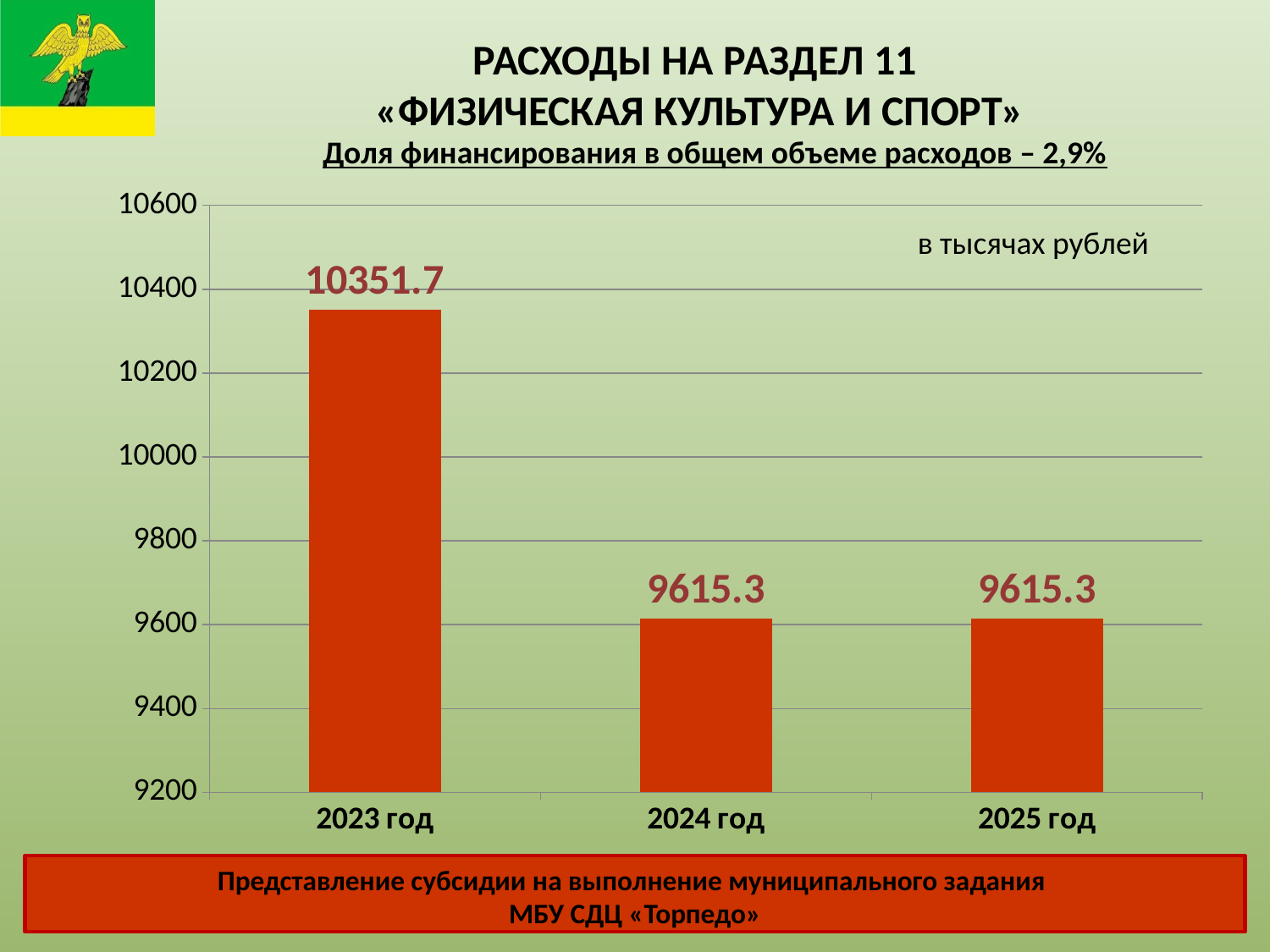
Is the value for 2024 год greater or less than 9800? less What is the value for 2023 год? 10351.7 Is the value for 2023 год greater or less than 10200? greater What is the value for 2025 год? 9615.3 Do the values rise or fall from 2023 год to 2024 год? fall What is the difference between the values for 2023 год and 2024 год? 736.4 Which year has the highest value? 2023 год In what units are the chart values given? в тысячах рублей What kind of chart is shown on the slide? bar chart Which is larger, the value for 2023 год or the value for 2025 год? 2023 год How many bars are shown in the chart? 3 What is the value for 2024 год? 9615.3